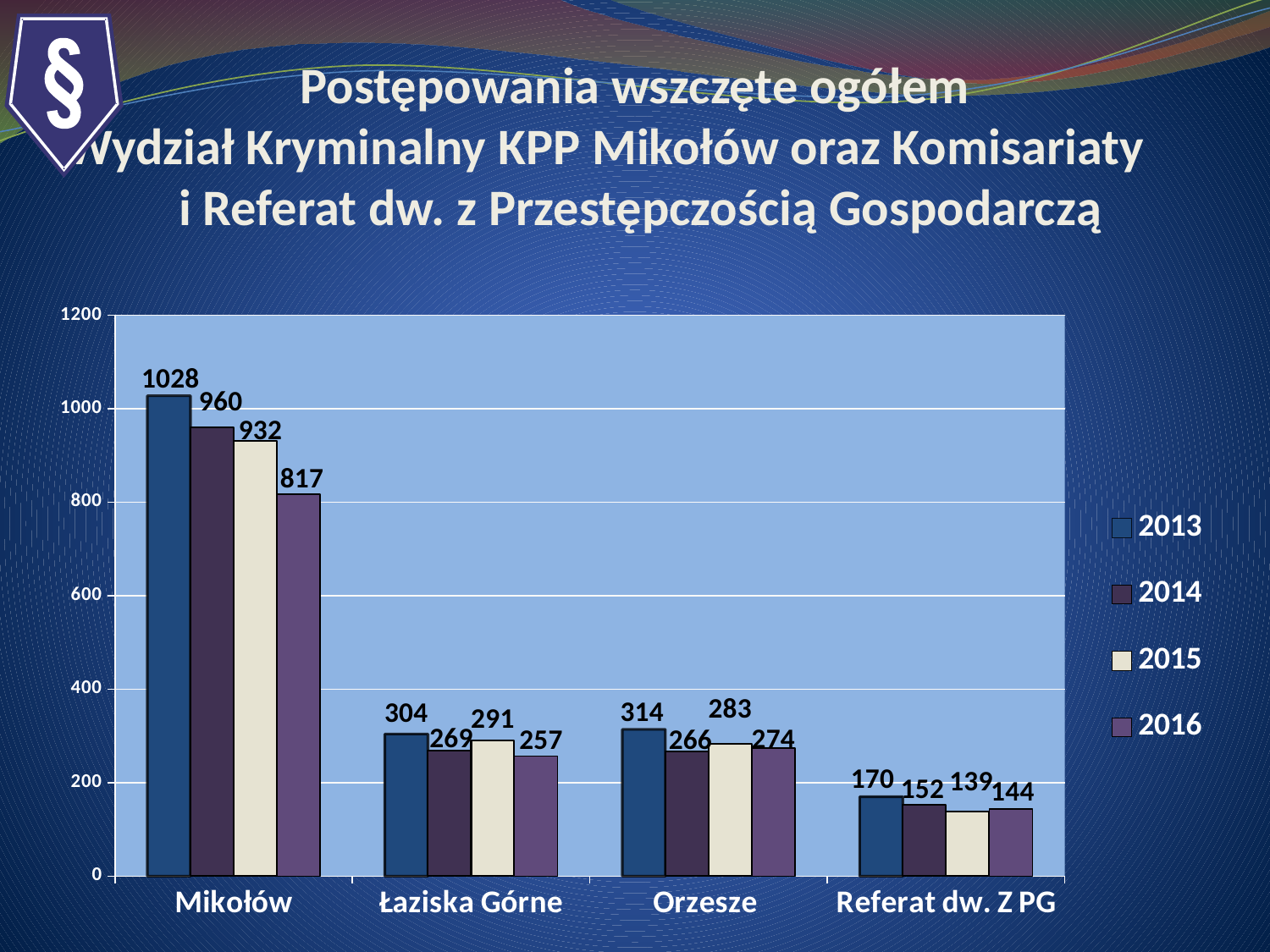
What is the value for Mikołów in 2013? 1028 How many categories are shown on the x axis? 4 What is the value for Orzesze in 2016? 274 Which category has the lowest value in 2016? Referat dw. Z PG What kind of chart is shown on the slide? bar chart Do the values for Mikołów rise or fall from 2013 to 2016? fall Which year does the lightest (cream-coloured) bar represent in the legend? 2015 What is the difference between the 2013 and 2016 values for Mikołów? 211 How many series does the legend list? 4 Which category has the highest value in 2014? Mikołów What is the value for Referat dw. Z PG in 2015? 139 Which is larger, the 2015 value for Łaziska Górne or the 2015 value for Orzesze? Łaziska Górne